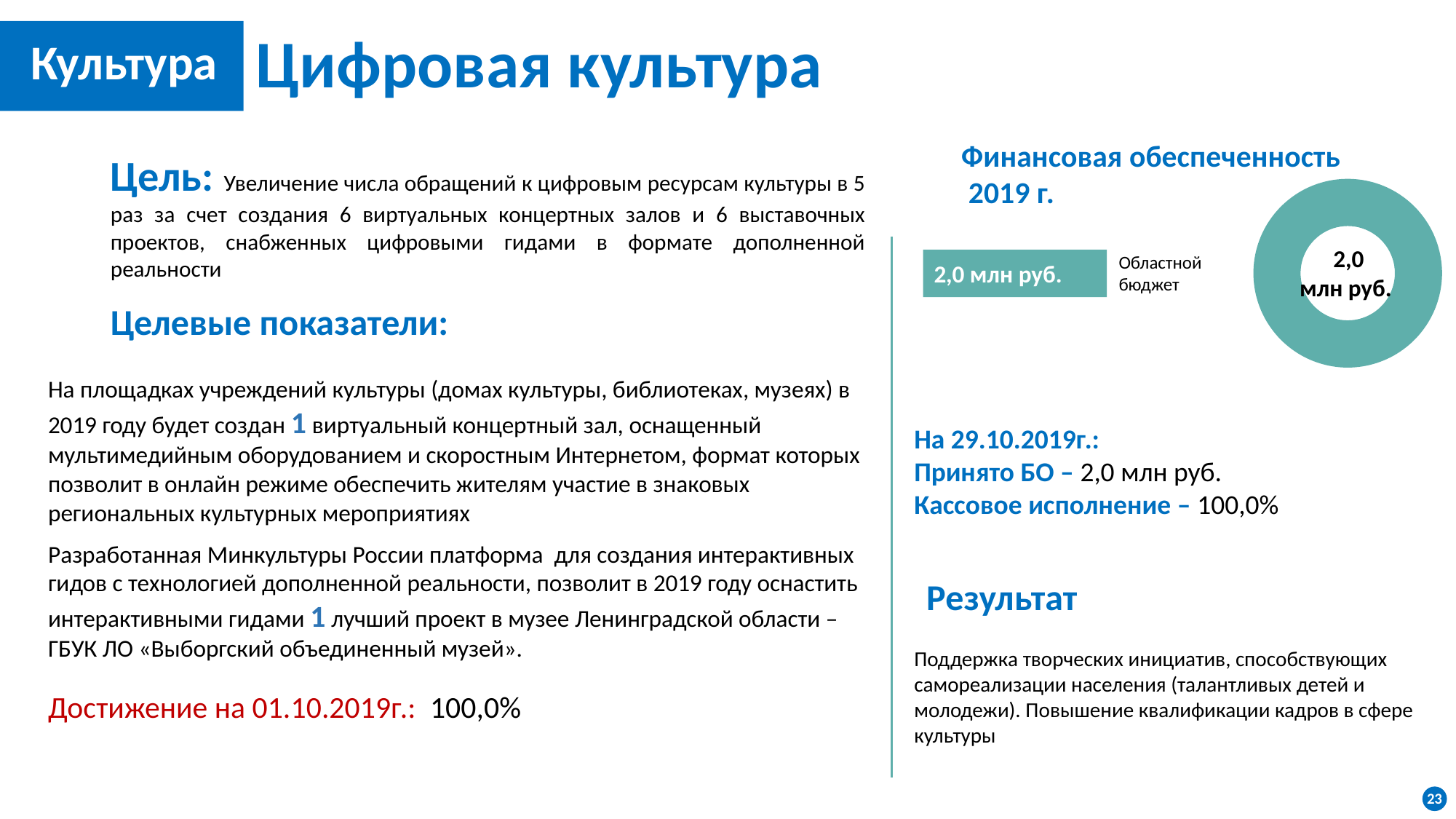
What share of the "Финансовая обеспеченность 2019 г." chart does Областной бюджет account for? 100% In the "Финансовая обеспеченность 2019 г." chart, what value is printed in the centre of the ring? 2,0 млн руб. In the "Финансовая обеспеченность 2019 г." chart, what is the value for Областной бюджет? 2,0 млн руб. What is the name of the only legend entry in the "Финансовая обеспеченность 2019 г." chart? Областной бюджет How many entries does the legend of the "Финансовая обеспеченность 2019 г." chart list? 1 What is the title of the chart on the right side of the slide? Финансовая обеспеченность 2019 г. What is the total value represented by the "Финансовая обеспеченность 2019 г." chart? 2,0 млн руб. How many slices does the "Финансовая обеспеченность 2019 г." chart contain? 1 What kind of chart is shown under the heading "Финансовая обеспеченность 2019 г."? doughnut chart